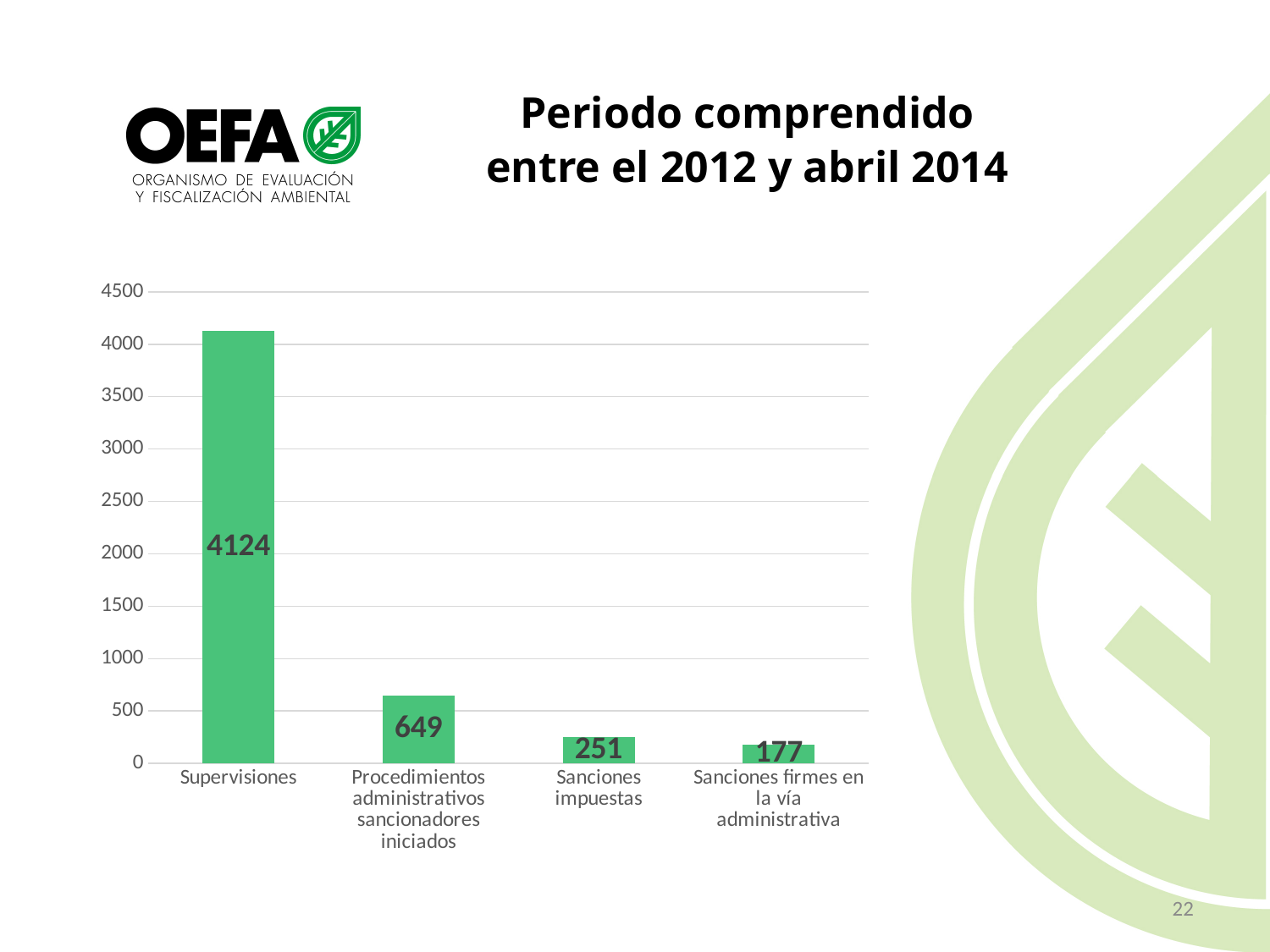
Which is larger, Sanciones impuestas or Sanciones firmes en la vía administrativa? Sanciones impuestas What is the difference between Supervisiones and Procedimientos administrativos sancionadores iniciados? 3475 What is the value for Procedimientos administrativos sancionadores iniciados? 649 What is the value for Sanciones impuestas? 251 Which category has the lowest value? Sanciones firmes en la vía administrativa How many categories are shown in the chart? 4 What kind of chart is shown on the slide? Bar chart Do the values rise or fall from left to right across the categories? Fall What is the value for Sanciones firmes en la vía administrativa? 177 What is the value for Supervisiones? 4124 What is the difference between Sanciones impuestas and Sanciones firmes en la vía administrativa? 74 Which category has the highest value? Supervisiones